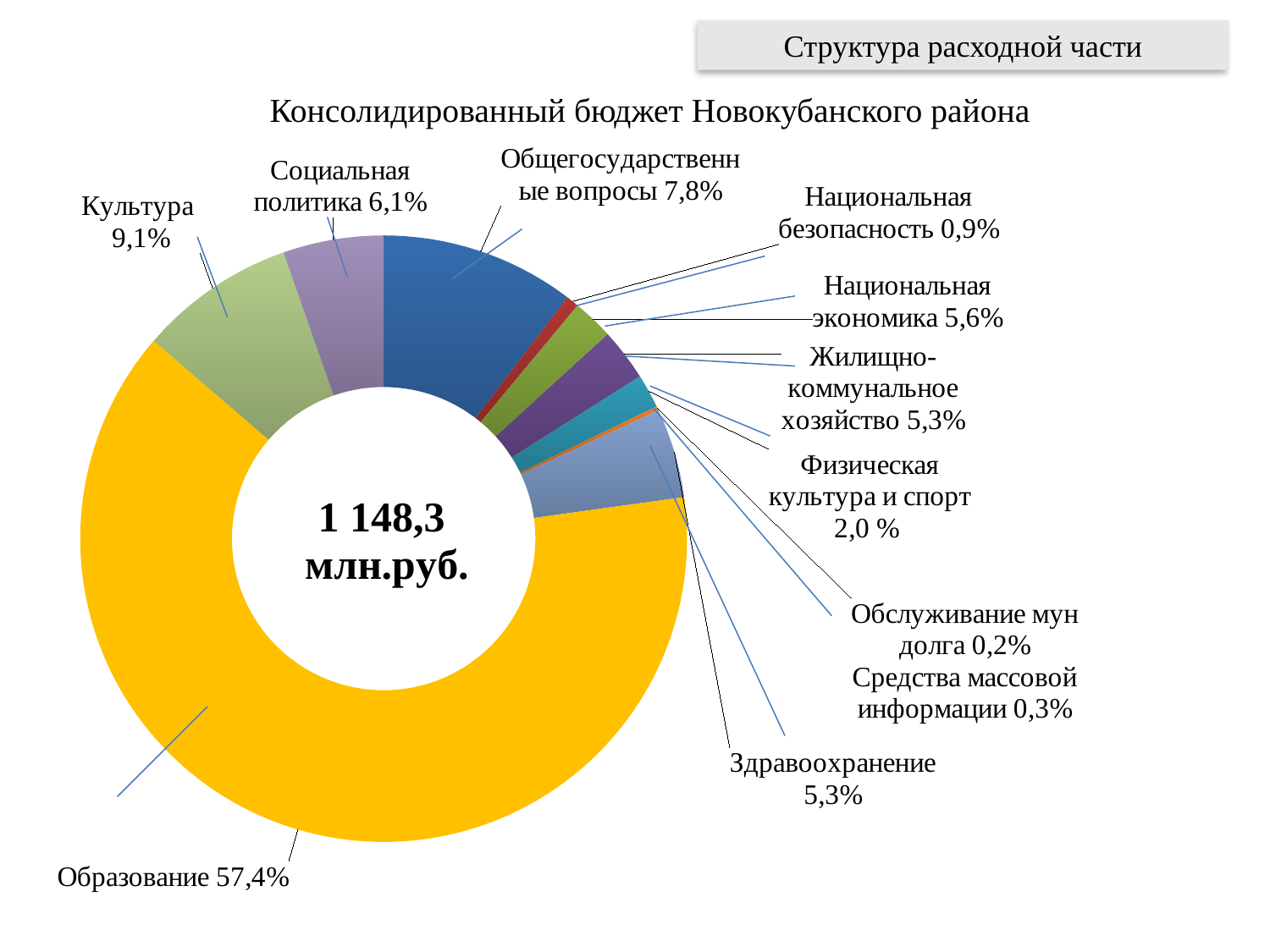
What share is labelled for Здравоохранение? 5,3% What percentage is shown for Культура? 9,1% What is the value for Национальная экономика? 5,6% Which is larger: Национальная безопасность or Физическая культура и спорт? Физическая культура и спорт What total amount is printed in the centre of the chart? 1 148,3 млн.руб. What share of the budget goes to Образование? 57,4% What is the difference in percentage points between Общегосударственные вопросы and Социальная политика? 1,7 What type of chart is shown on the slide? Doughnut (pie) chart Which category has the smallest share of the budget? Обслуживание мун долга Which is larger: the share for Культура or the share for Общегосударственные вопросы? Культура How many categories are shown in the chart? 11 Which category has the largest share of the budget? Образование